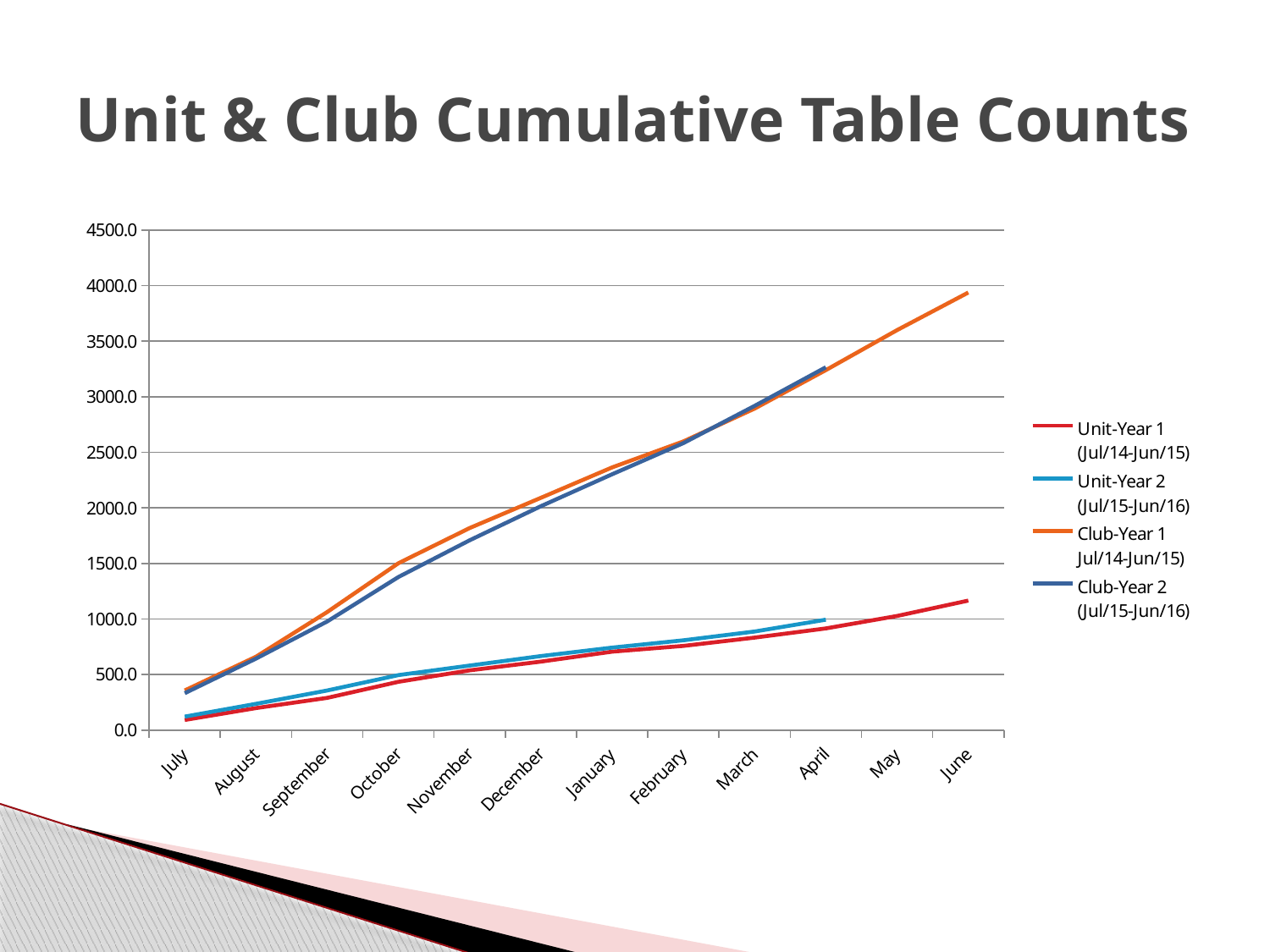
Which series is drawn in orange? Club-Year 1 Jul/14-Jun/15) In June, which is larger: the value for Club-Year 1 or the value for Unit-Year 1? Club-Year 1 How many series does the legend list? 4 Do the values for Club-Year 1 rise or fall from July to June? rise What is the title of the chart? Unit & Club Cumulative Table Counts Which series reaches the highest value on the chart? Club-Year 1 Jul/14-Jun/15) Is the value for Unit-Year 1 in June greater or less than 1000? greater How many months are shown along the x axis? 12 Is the value for Unit-Year 1 in July greater or less than 500? less Is the value for Club-Year 1 in June greater or less than 3500? greater What kind of chart is shown on the slide? line chart